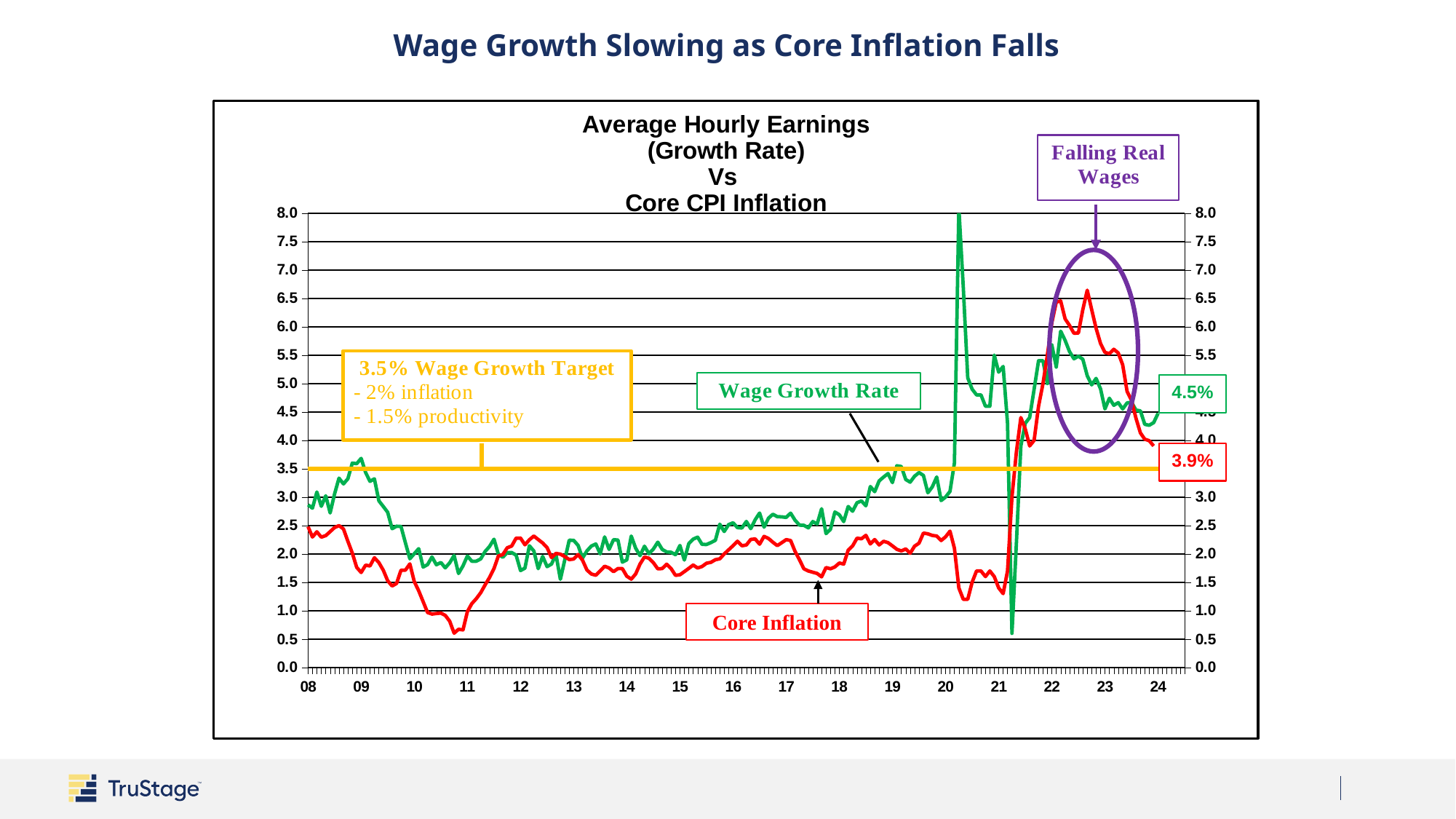
What value is the yellow horizontal Wage Growth Target line set at? 3.5% Is the peak of the Core Inflation line around 2022 greater or less than 6.0? greater What kind of chart is shown on the slide? line chart Which series reaches the highest value anywhere on the chart? Wage Growth Rate What is the most recent value labelled for the Core Inflation line? 3.9% Does the Core Inflation line rise or fall from its 2022 peak to the end of the chart? fall What is the difference between the latest labelled Wage Growth Rate (4.5%) and the latest labelled Core Inflation (3.9%)? 0.6% Is the lowest point of the Core Inflation line around 2010–2011 greater or less than 1.0? less What is the most recent value labelled for the Wage Growth Rate line? 4.5% Is the peak of the Wage Growth Rate line around 2020 greater or less than 7.0? greater What does the purple oval annotation on the chart say? Falling Real Wages Which is larger at the end of the chart, the labelled Wage Growth Rate or the labelled Core Inflation? Wage Growth Rate